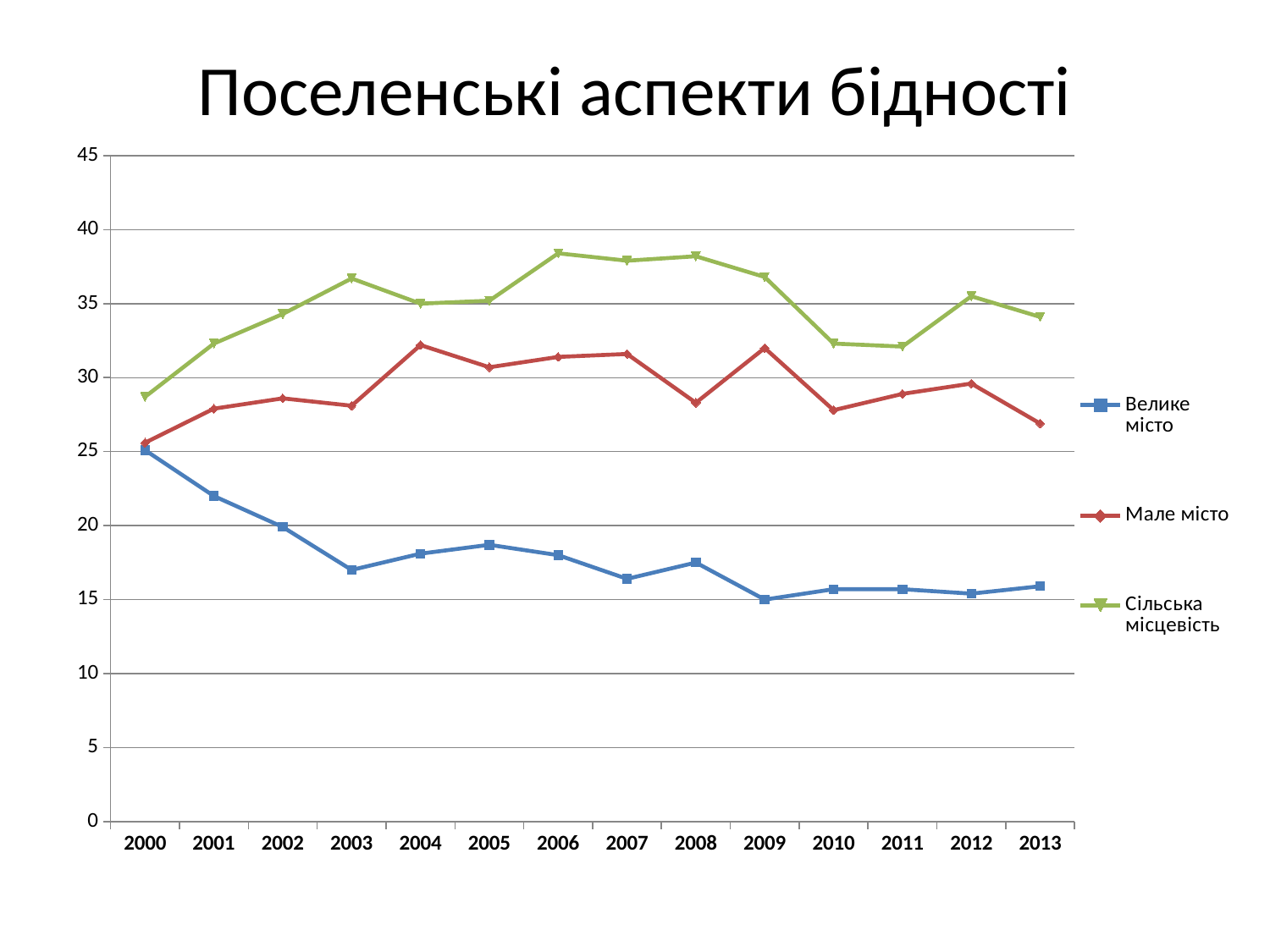
Does the value for Велике місто rise or fall overall from 2000 to 2013? fall Is the value for Мале місто in 2004 greater or less than 30? greater In which year is the value for Мале місто lowest? 2000 In 2013, which is larger: Сільська місцевість or Велике місто? Сільська місцевість What is the title of the chart? Поселенські аспекти бідності How many years are shown on the x axis? 14 Which series is shown with the green line? Сільська місцевість How many series does the legend list? 3 What kind of chart is shown on the slide? line chart Is the value for Велике місто in 2003 greater or less than 20? less Is the value for Сільська місцевість in 2006 greater or less than 35? greater